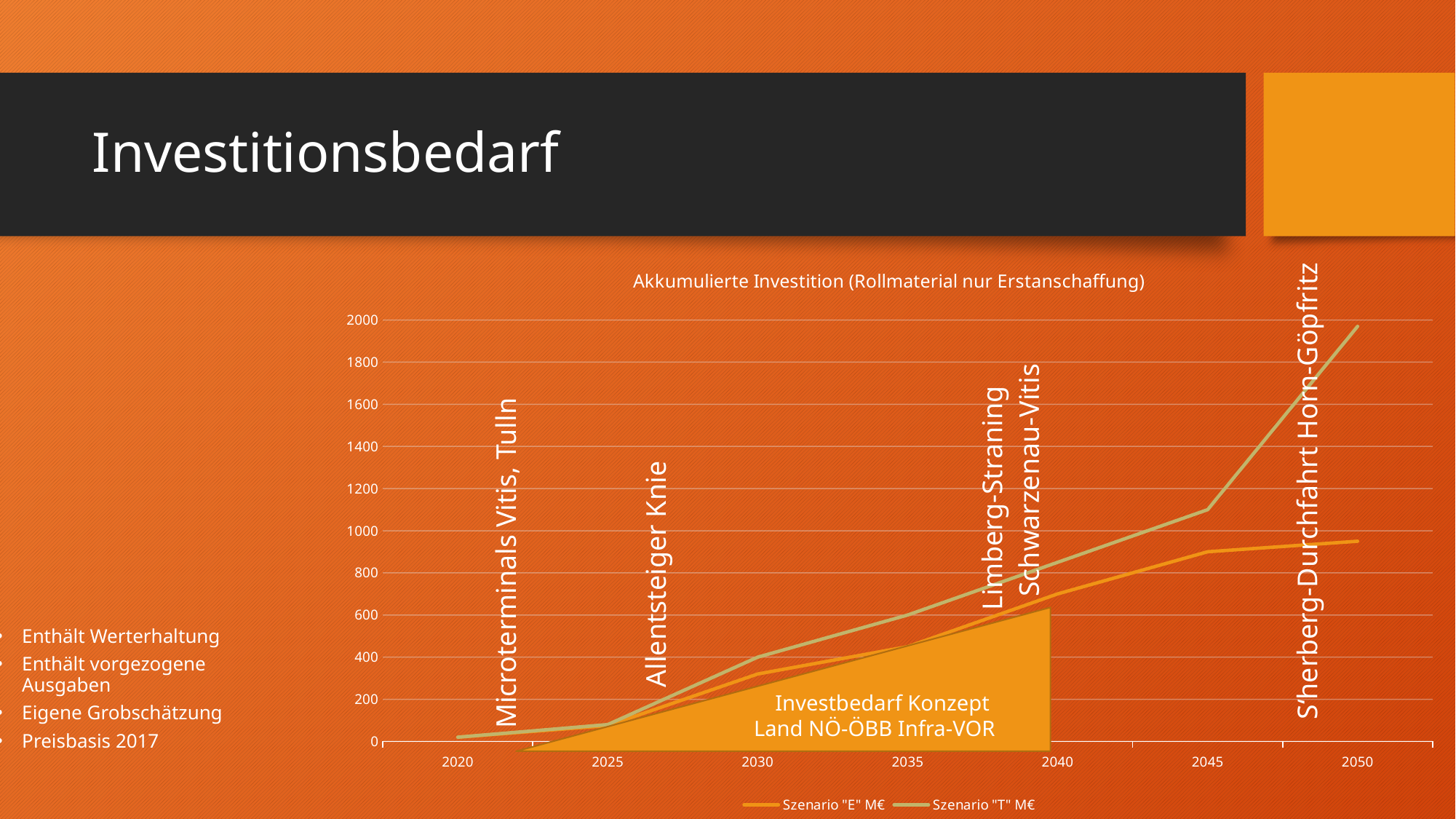
In 2050, which series has the larger value, Szenario "E" M€ or Szenario "T" M€? Szenario "T" M€ Is the value for Szenario "T" M€ in 2045 greater or less than 1000? greater Is the value for Szenario "E" M€ in 2030 greater or less than 400? less How many series does the legend list? 2 Is the value for Szenario "T" M€ in 2050 greater or less than 1800? greater What kind of chart is shown on the slide? line chart Do the values for Szenario "T" M€ rise or fall from 2020 to 2050? rise Which series is drawn in orange according to the legend? Szenario "E" M€ How many year labels are shown on the x axis? 7 What is the title of the chart? Akkumulierte Investition (Rollmaterial nur Erstanschaffung)